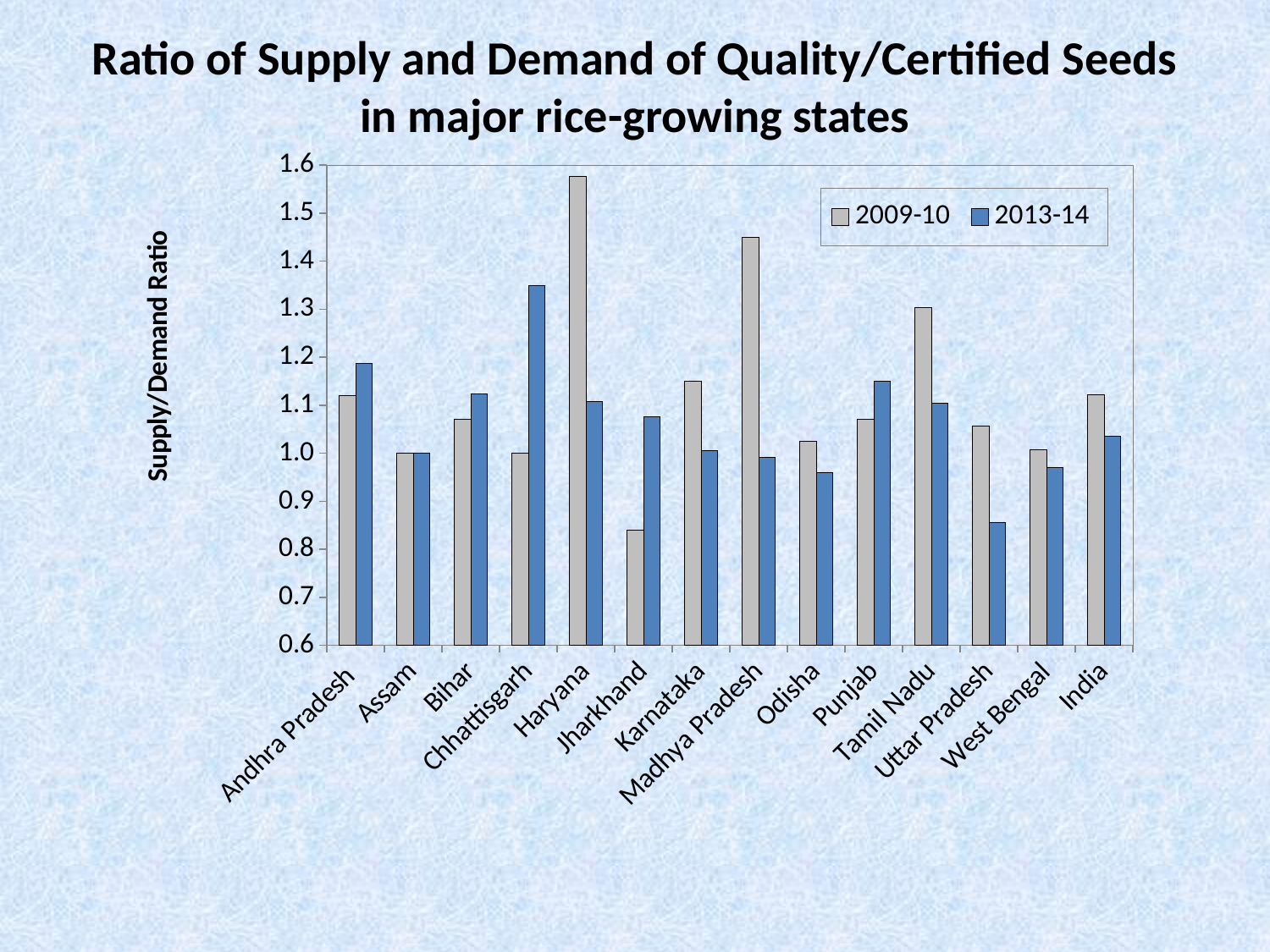
Is the 2013-14 value for Odisha greater or less than 1.0? less Which category has the highest 2009-10 supply/demand ratio? Haryana Is the 2009-10 value for Haryana greater or less than 1.5? greater Which category has the lowest 2009-10 supply/demand ratio? Jharkhand For Tamil Nadu, which series has the larger value, 2009-10 or 2013-14? 2009-10 Which category has the lowest 2013-14 supply/demand ratio? Uttar Pradesh How many categories are shown on the x axis? 14 Is the 2009-10 value for Madhya Pradesh greater or less than 1.4? greater How many series does the legend list? 2 Which category has the highest 2013-14 supply/demand ratio? Chhattisgarh For Chhattisgarh, which series has the larger value, 2009-10 or 2013-14? 2013-14 What kind of chart is shown on the slide? bar chart